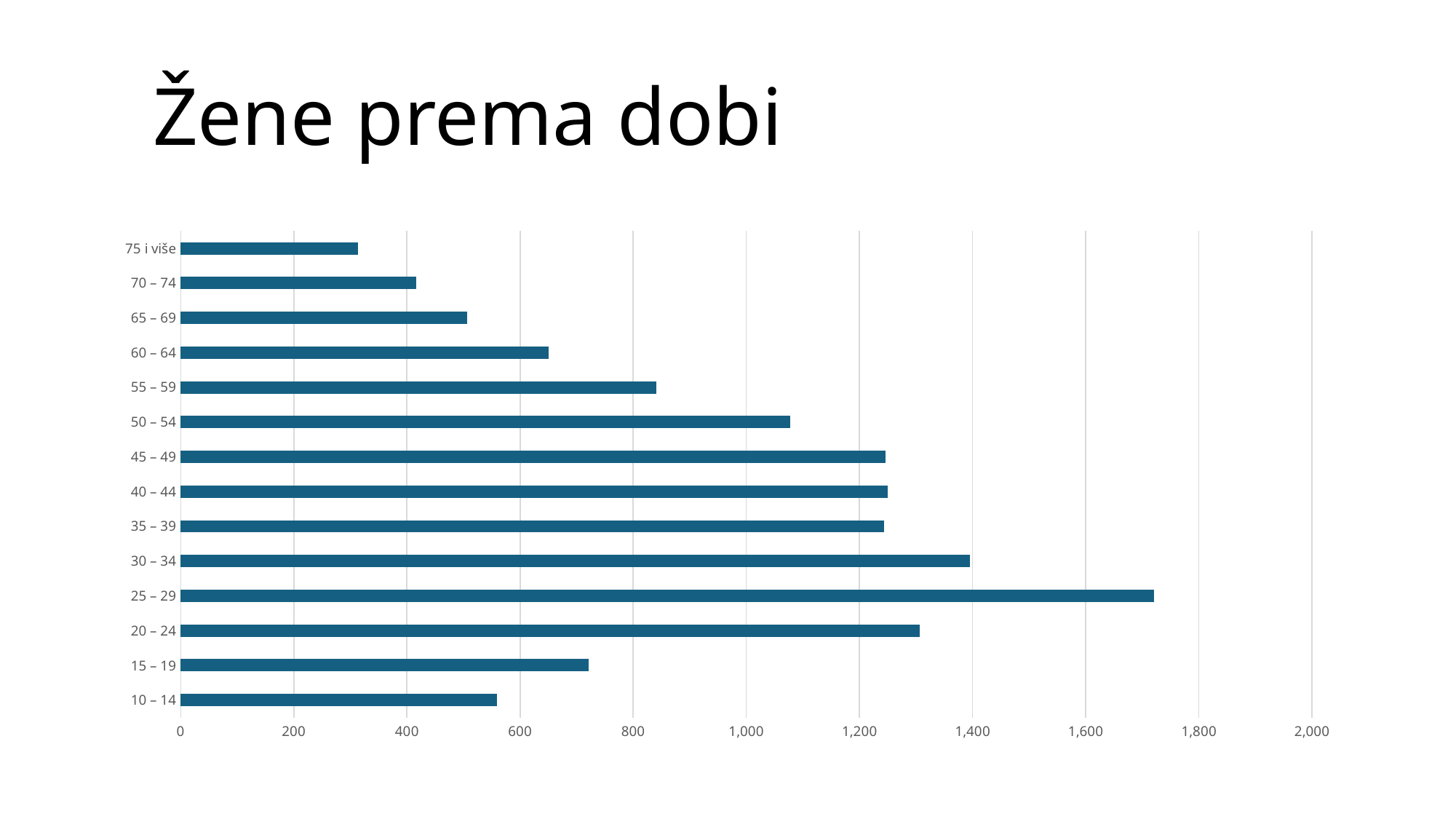
Is the value for 70 – 74 greater or less than 600? less Is the value for 25 – 29 greater or less than 1,600? greater Which has the larger value, 30 – 34 or 20 – 24? 30 – 34 Which age category has the lowest value? 75 i više Is the value for 65 – 69 greater or less than 600? less How many age categories are plotted in the chart? 14 Which age category has the highest value? 25 – 29 What is the title of the chart on the slide? Žene prema dobi Which has the larger value, 55 – 59 or 15 – 19? 55 – 59 What kind of chart is shown on the slide? bar chart